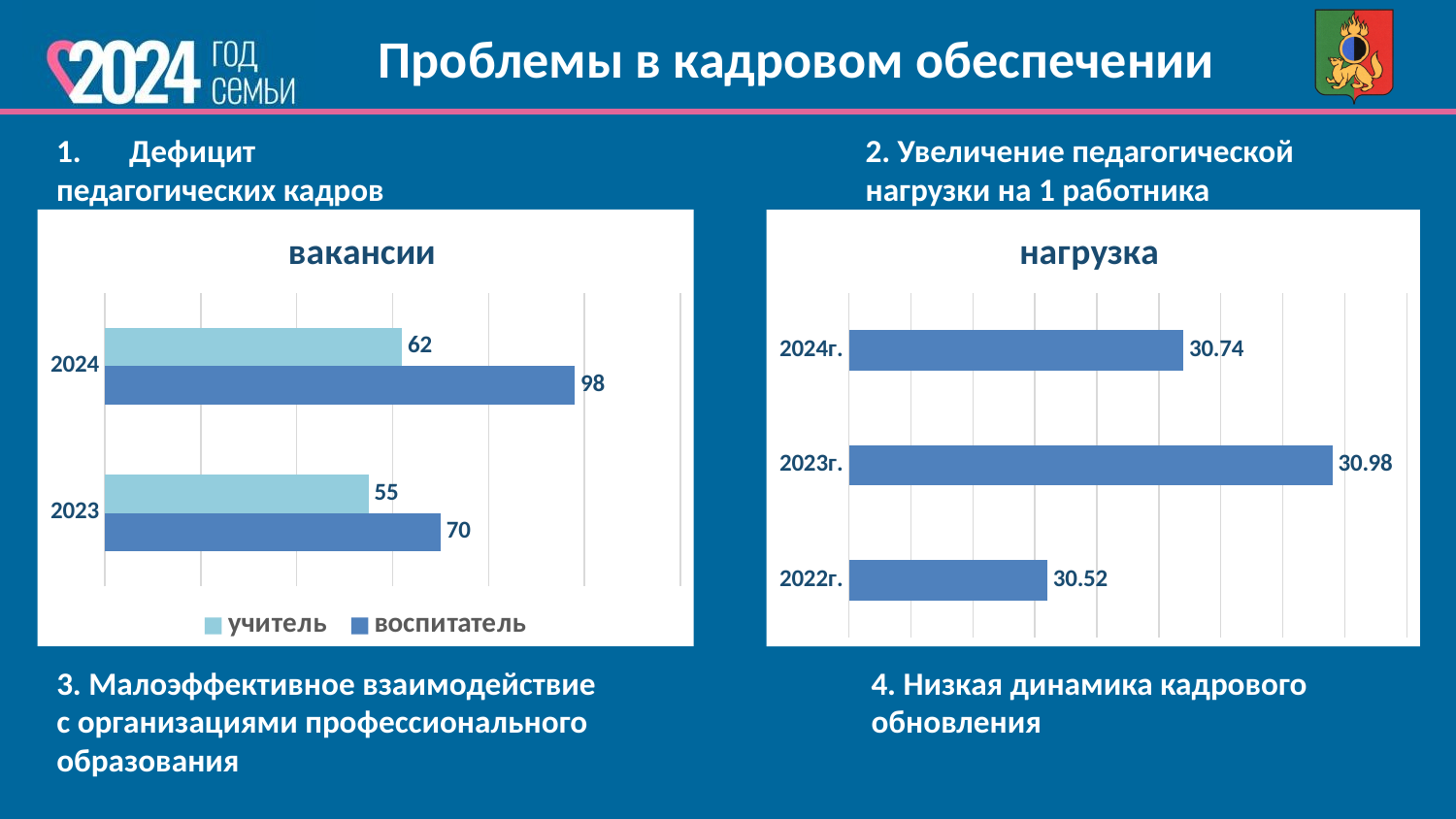
In the chart titled "вакансии", which colour represents учитель? light blue In the chart titled "нагрузка", which year has the lowest value? 2022г. In the chart titled "вакансии", what kind of chart is shown? bar chart In the chart titled "нагрузка", which year has the highest value? 2023г. In the chart titled "вакансии", what is the value for воспитатель in 2024? 98 In the chart titled "вакансии", what is the difference between the воспитатель and учитель values in 2024? 36 In the chart titled "вакансии", which is larger in 2023: учитель or воспитатель? воспитатель In the chart titled "вакансии", how many series does the legend list? 2 In the chart titled "вакансии", what is the value for учитель in 2023? 55 In the chart titled "нагрузка", what is the value for 2023г.? 30.98 In the chart titled "нагрузка", how many categories are shown? 3 In the chart titled "нагрузка", what is the difference between the values for 2023г. and 2022г.? 0.46